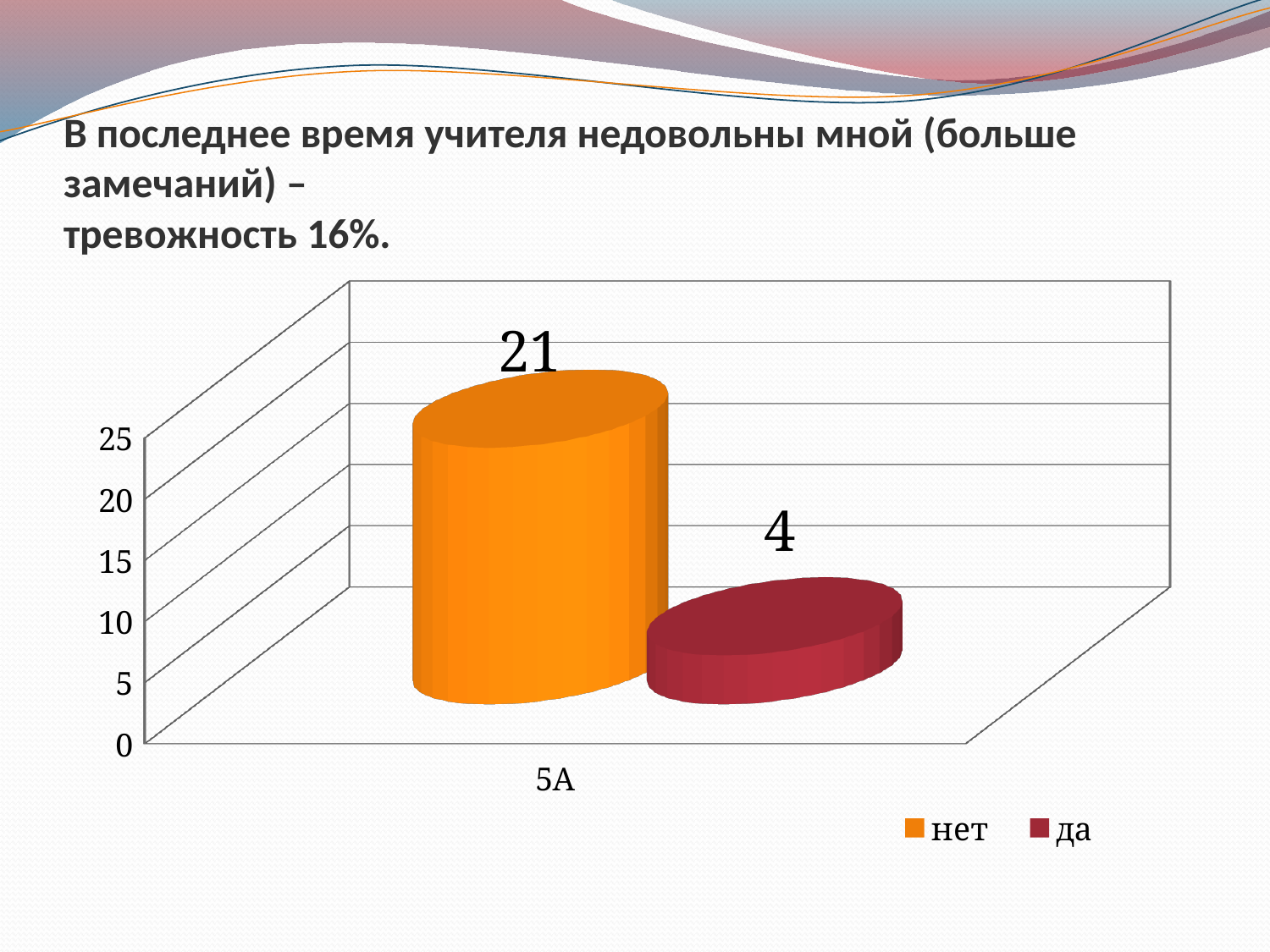
Is the value for "да" greater or less than 5? less What is the label of the category on the x axis? 5А What colour represents the "да" series in the legend? dark red Which series has the higher value: "нет" or "да"? нет What is the value for "нет" in the 5А category? 21 Is the value for "нет" greater or less than 20? greater How many series does the legend list? 2 Which series has the lowest value on the chart? да How many categories are shown on the x axis? 1 What is the value for "да" in the 5А category? 4 What is the difference between the values for "нет" and "да"? 17 What kind of chart is shown on the slide? bar chart